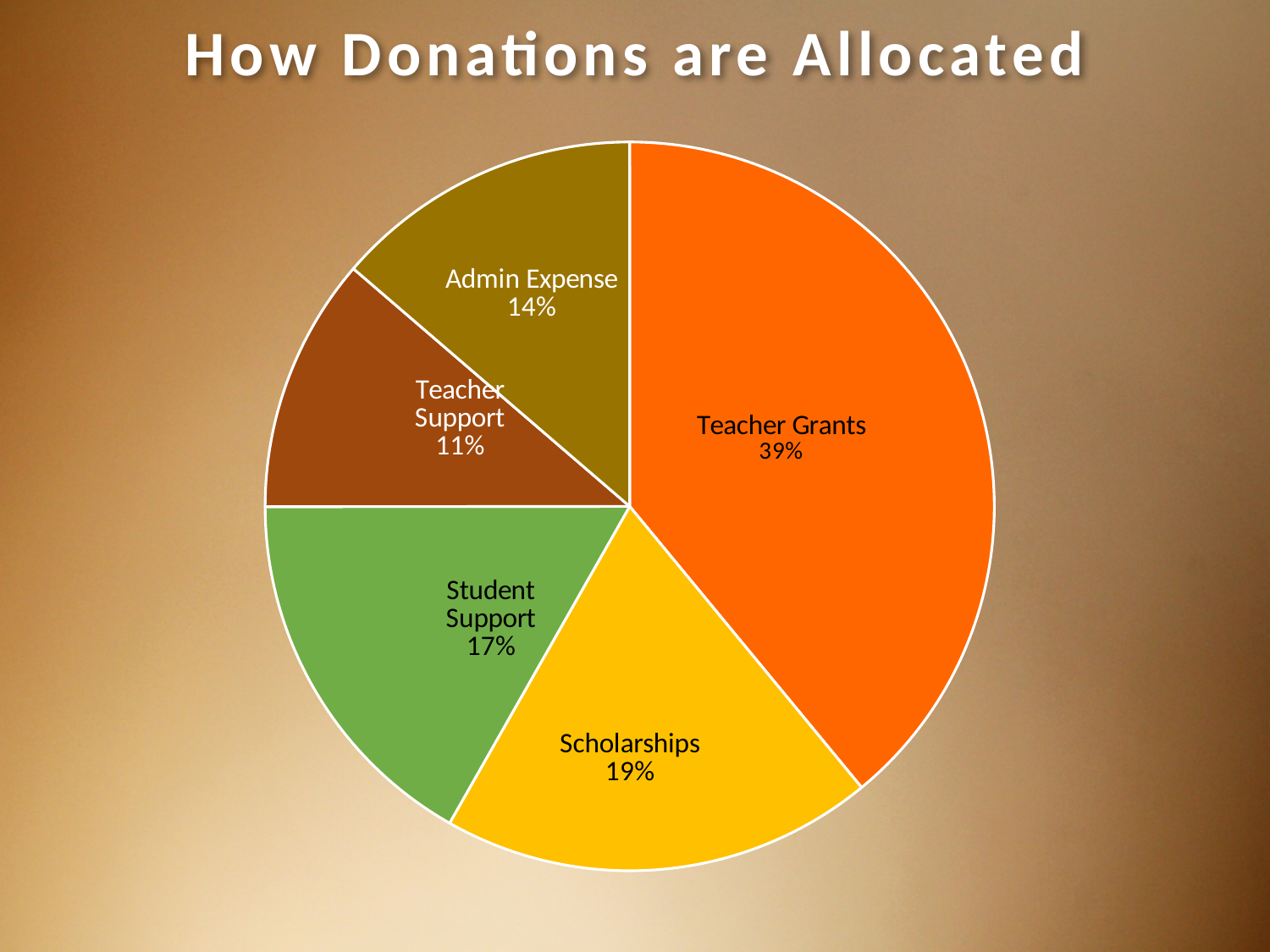
How many categories are shown in the pie chart? 5 What share of donations is allocated to Teacher Support? 11% What percentage of donations is allocated to Scholarships? 19% What kind of chart is shown on the slide? Pie chart Which category receives the largest share of donations? Teacher Grants What is the title of the chart? How Donations are Allocated What percentage of donations goes to Admin Expense? 14% How many percentage points larger is the Teacher Grants share than the Scholarships share? 20 What share of donations is allocated to Student Support? 17% Which category receives the smallest share of donations? Teacher Support What share of donations goes to Teacher Grants? 39% Which receives a larger share of donations, Student Support or Admin Expense? Student Support